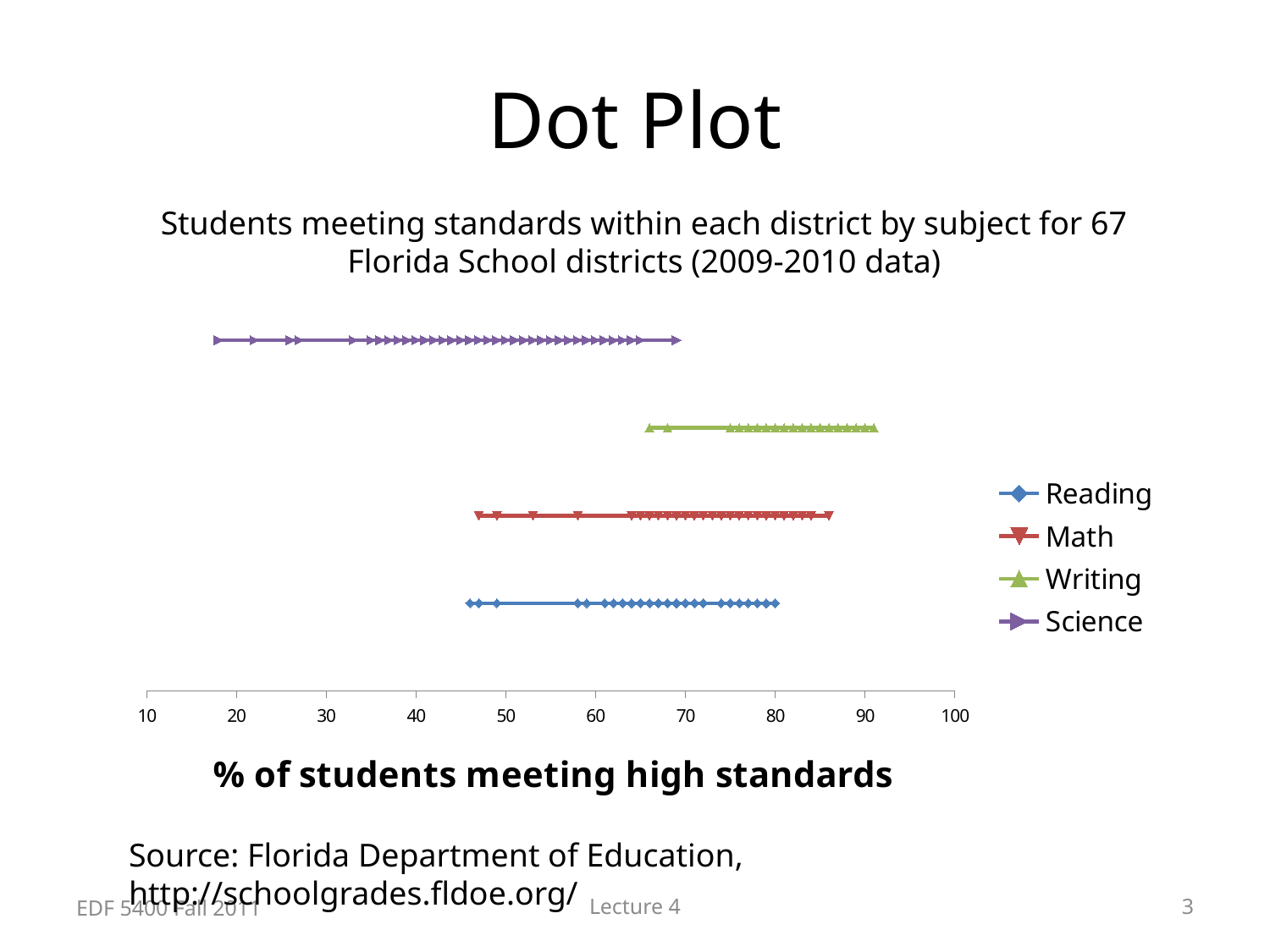
Which series has the highest plotted value on the chart? Writing Which series has the lowest plotted value on the chart? Science Is the lowest Reading value greater or less than 50? less Which series is plotted in purple? Science Is the highest Math value greater or less than 80? greater How many series does the legend list? 4 What is the label of the x axis? % of students meeting high standards What kind of chart is shown on the slide? Dot plot Is the lowest Science value greater or less than 20? less Which series spans the widest range of values, Science or Writing? Science